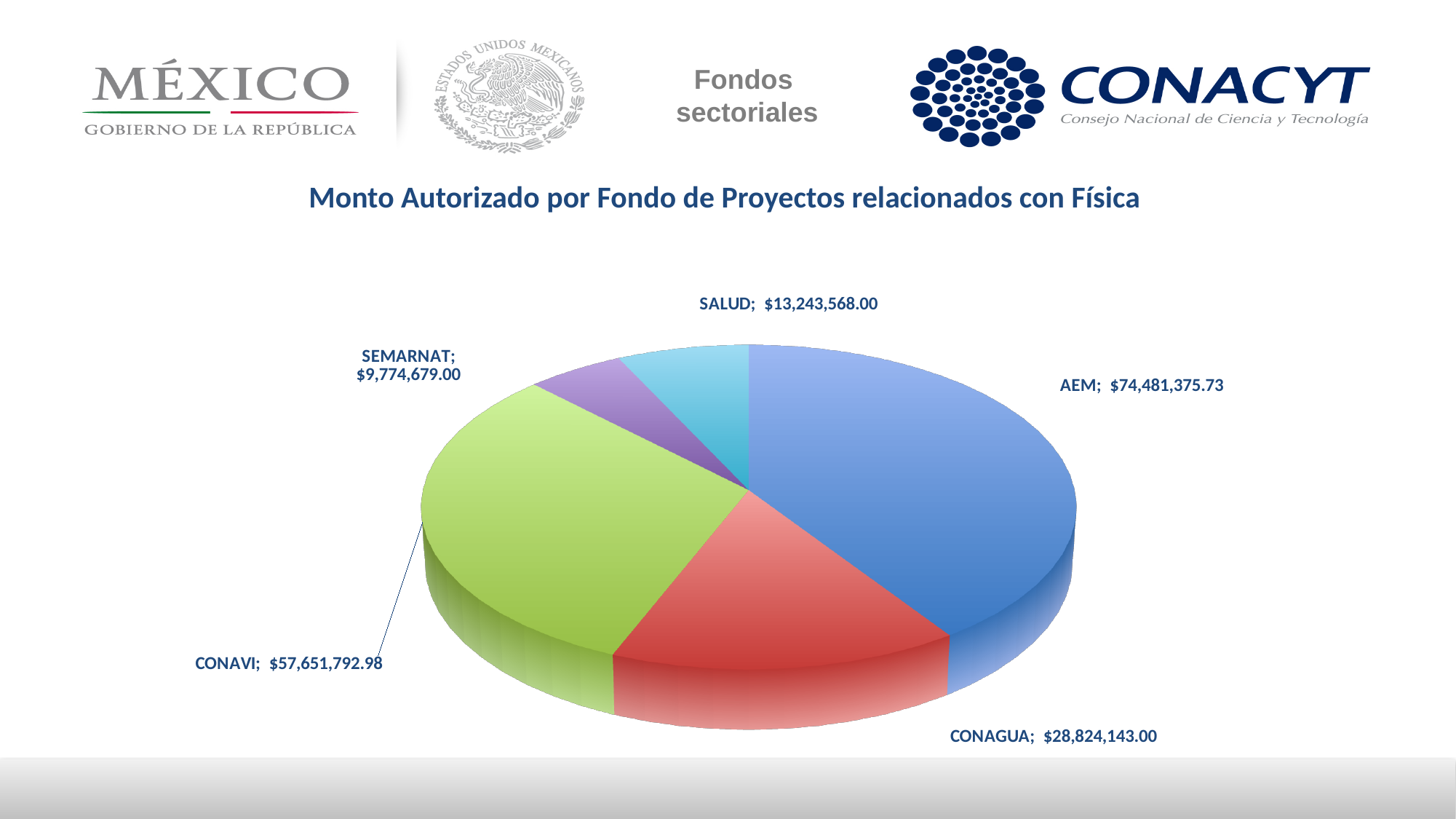
What is the authorized amount for SALUD? $13,243,568.00 What is the title of the chart? Monto Autorizado por Fondo de Proyectos relacionados con Física Which fund has the largest authorized amount? AEM What type of chart is shown on the slide? Pie chart Which fund has a larger authorized amount, CONAVI or CONAGUA? CONAVI What is the difference between the authorized amounts for AEM and CONAVI? $16,829,582.75 What is the difference between the authorized amounts for SALUD and SEMARNAT? $3,468,889.00 Which fund has the smallest authorized amount? SEMARNAT What is the authorized amount for SEMARNAT? $9,774,679.00 What is the authorized amount for AEM? $74,481,375.73 What is the authorized amount for CONAGUA? $28,824,143.00 How many funds (slices) are shown in the pie chart? 5